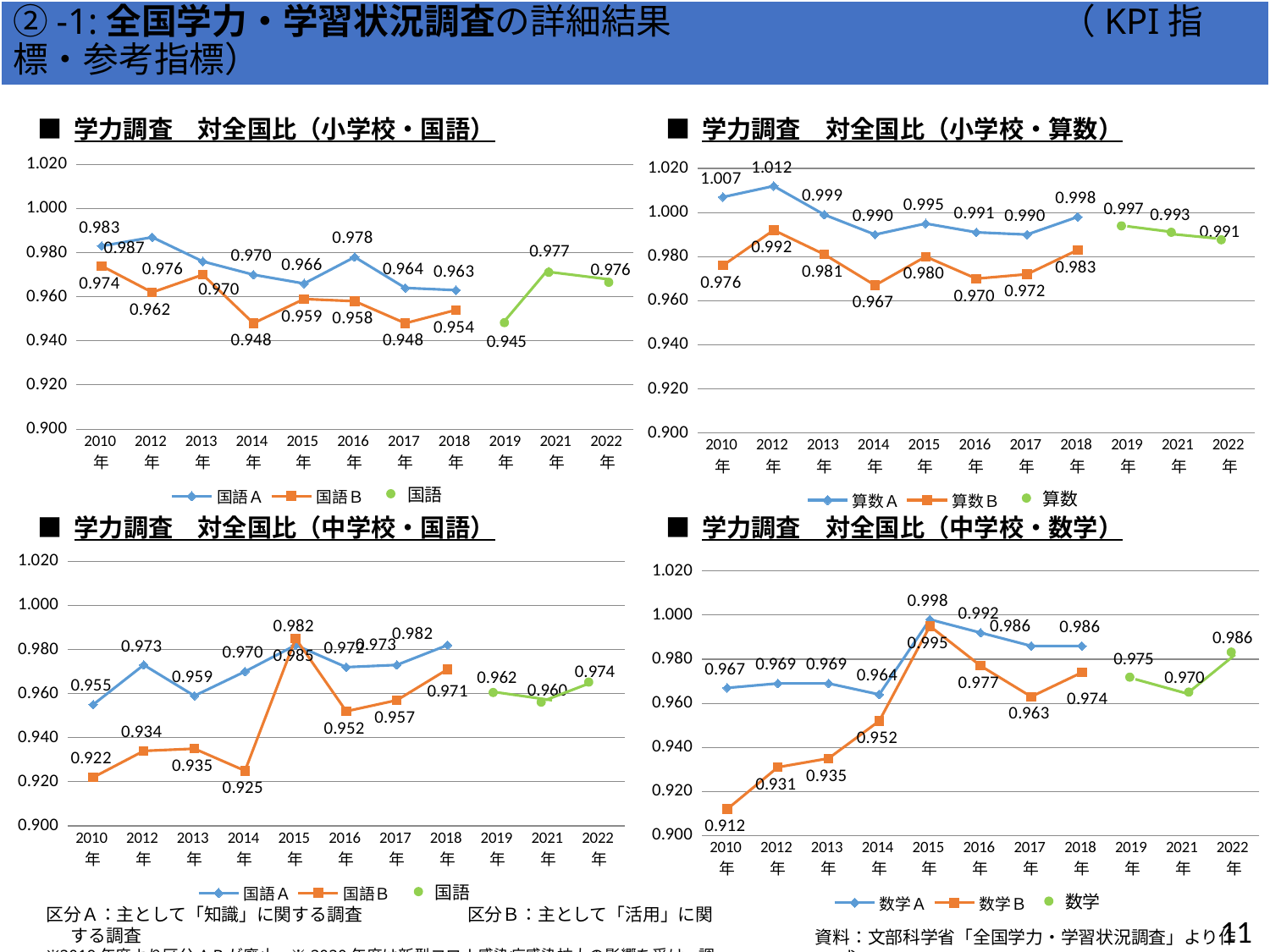
In the 中学校・数学 chart (bottom right), what is the difference between 数学A in 2015年 and 数学A in 2014年? 0.034 How many series does the legend of the 小学校・算数 chart (top right) list? 3 In the 小学校・国語 chart (top left), what is the value of 国語 in 2019年? 0.945 In the 中学校・国語 chart (bottom left), which year has the lowest value for 国語B? 2010年 In the 中学校・数学 chart (bottom right), is the value of 数学B in 2013年 greater or less than 0.940? less What kind of chart is the 小学校・国語 chart (top left)? line chart How many years are shown on the x axis of the 中学校・国語 chart (bottom left)? 11 In the 中学校・国語 chart (bottom left), which is larger in 2015年, 国語A or 国語B? 国語B In the 小学校・国語 chart (top left), what is the value of 国語A in 2010年? 0.983 In the 小学校・算数 chart (top right), what is the difference between 算数A and 算数B in 2014年? 0.023 In the 小学校・算数 chart (top right), which year has the highest value for 算数A? 2012年 In the 中学校・数学 chart (bottom right), what is the value of 数学B in 2010年? 0.912